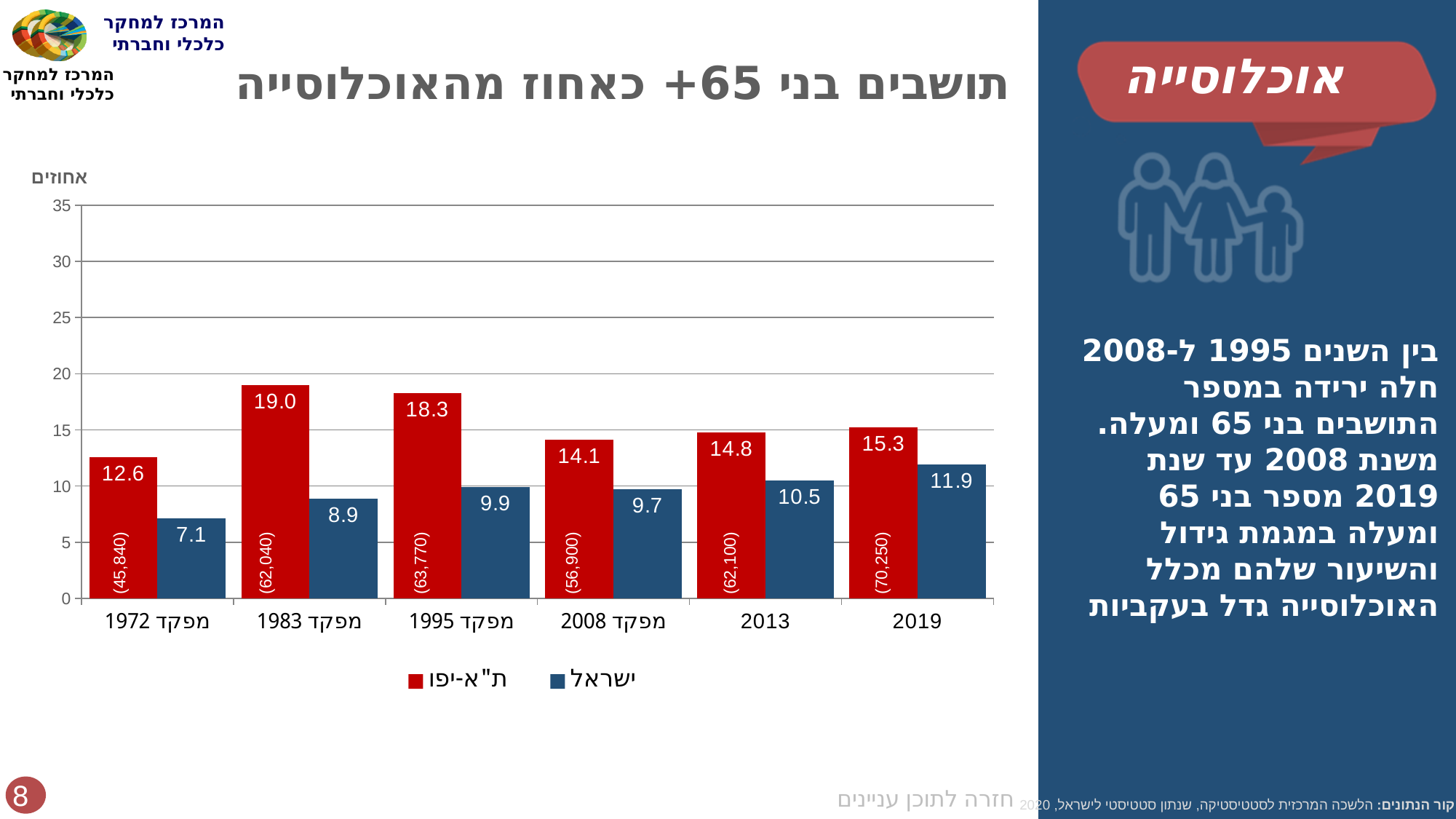
What kind of chart is shown on the slide? bar chart What is the value for ת"א-יפו in מפקד 1983? 19.0 How many categories are shown on the x axis? 6 What is the value for ישראל in 2019? 11.9 In which category is the ת"א-יפו value highest? מפקד 1983 Which is larger: the ת"א-יפו value in 2013 or in 2019? 2019 What number is printed in parentheses inside the ת"א-יפו bar for 2019? (70,250) How many series does the legend list? 2 In which category is the ישראל value lowest? מפקד 1972 What is the difference between the ת"א-יפו and ישראל values in מפקד 1995? 8.4 What is the value for ישראל in מפקד 1972? 7.1 Which colour represents ישראל in the chart? blue